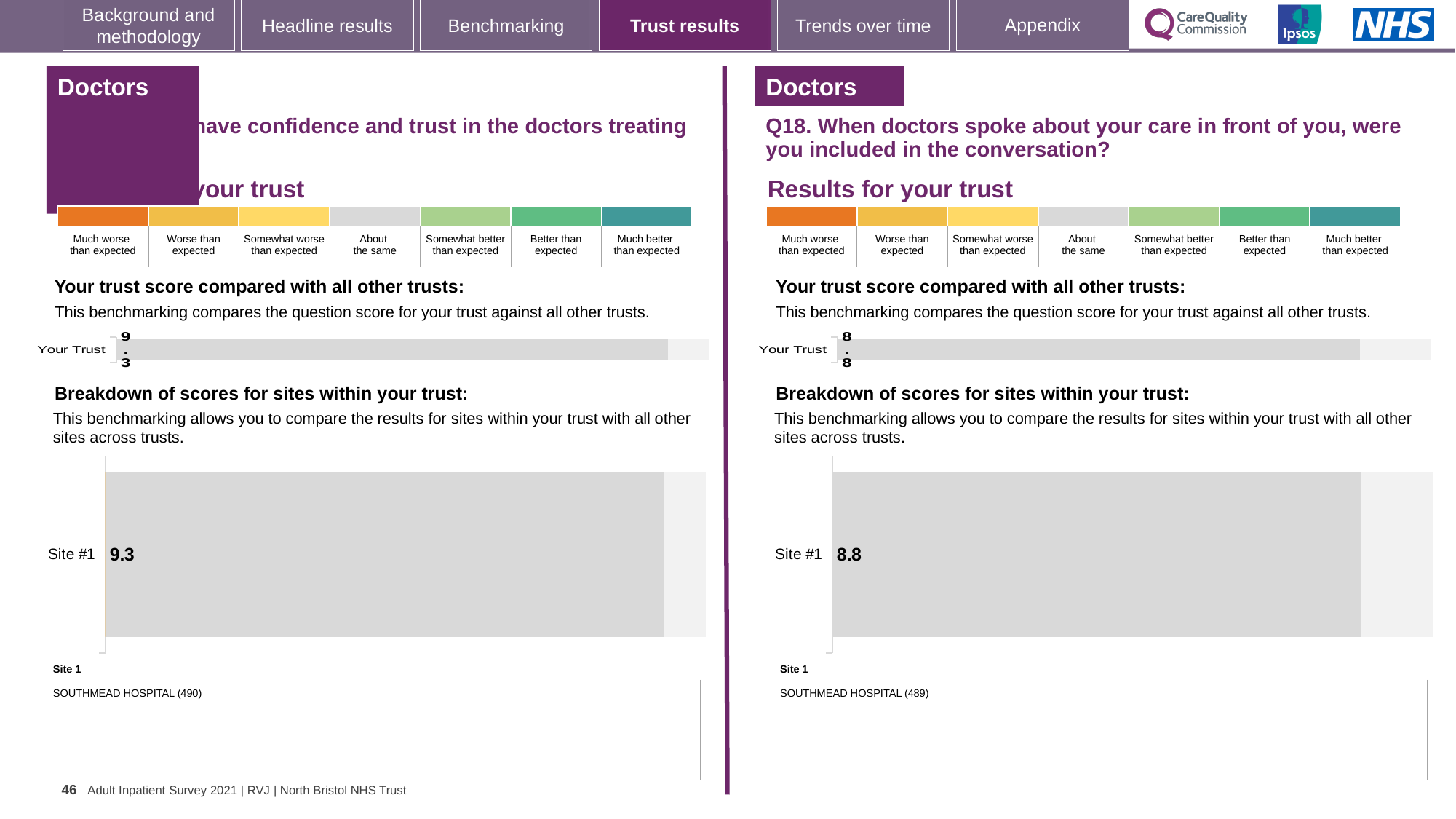
On the right panel, which site name is listed as Site 1 below the breakdown chart? SOUTHMEAD HOSPITAL (489) Is the Site #1 score on the left panel greater or less than 9? greater Which is larger: the Site #1 score on the left panel or the Site #1 score on the right panel (Q18)? Left panel (9.3) How many sites are shown in the breakdown of scores chart on the right panel (Q18)? 1 On the left panel, what score is shown for Site #1 in the breakdown of scores for sites chart? 9.3 What is the difference between the Your Trust score on the left panel and the Your Trust score on the right panel (Q18)? 0.5 On the left panel, which site name is listed as Site 1 below the breakdown chart? SOUTHMEAD HOSPITAL (490) On the right panel (Q18), what score is shown for Site #1 in the breakdown of scores for sites chart? 8.8 What type of chart is used to show the Site #1 score on the left panel? Bar chart On the left panel, what is the value shown for Your Trust in the trust score chart? 9.3 Is the Your Trust score on the right panel (Q18) greater or less than 9? less On the right panel (Q18), what is the value shown for Your Trust in the trust score chart? 8.8